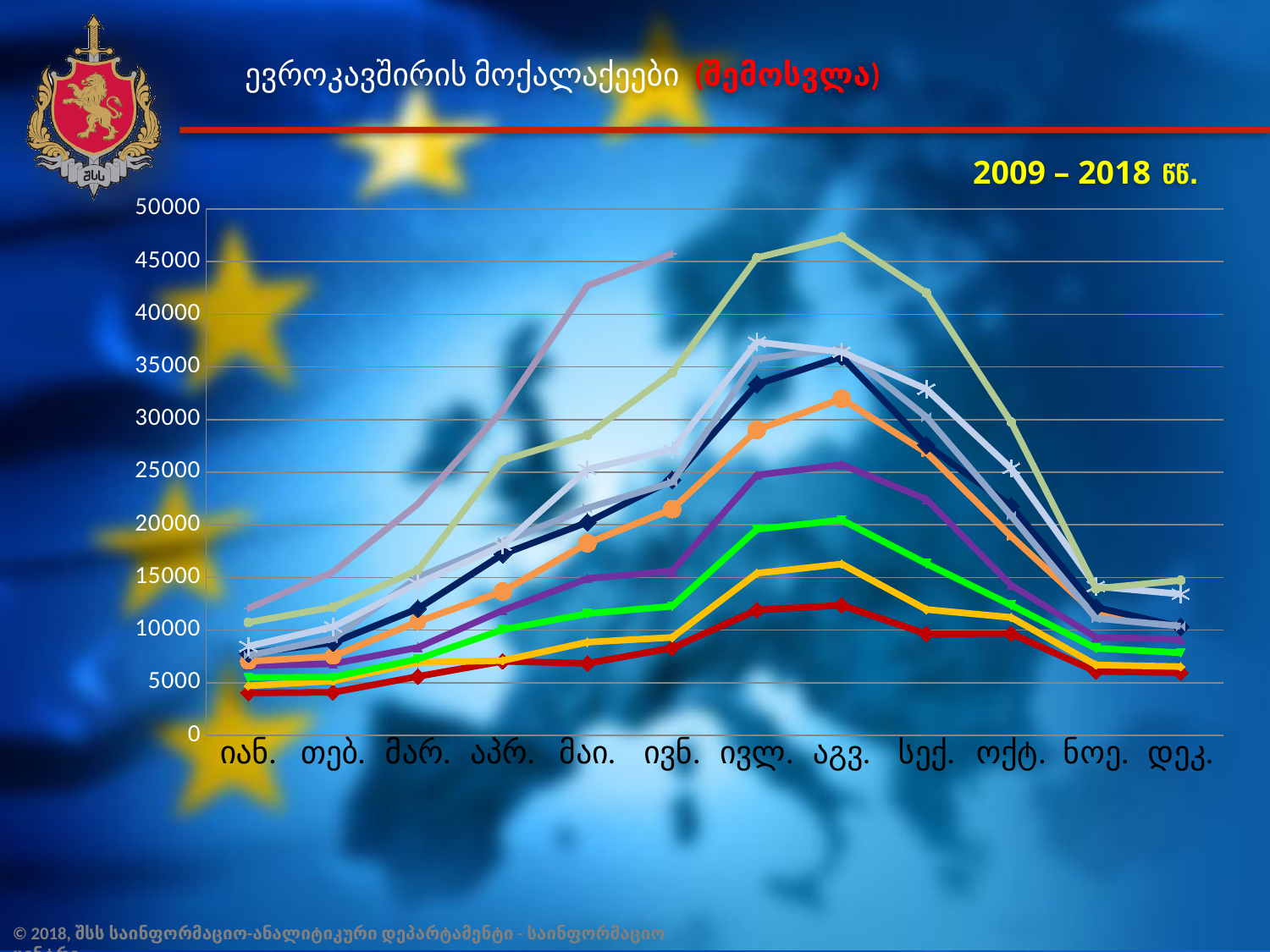
Is the value of the pale green line in აგვ. greater or less than 45000? greater Is the value of the bright green line in იან. greater or less than 10000? less In which month does the pale green line reach its lowest value? იან. From აგვ. to ნოე., does the orange line rise or fall? fall In აგვ., which is higher: the orange line or the purple line? the orange line What kind of chart is shown on the slide? line chart What is the title of the chart on the slide? ევროკავშირის მოქალაქეები (შემოსვლა) How many months are shown along the x axis of the chart? 12 In which month does the orange line reach its highest value? აგვ. Is the value of the red line in აგვ. greater or less than 10000? greater From იან. to ივნ., does the dark blue line rise or fall? rise Which range of years is indicated above the chart? 2009 – 2018 წწ.